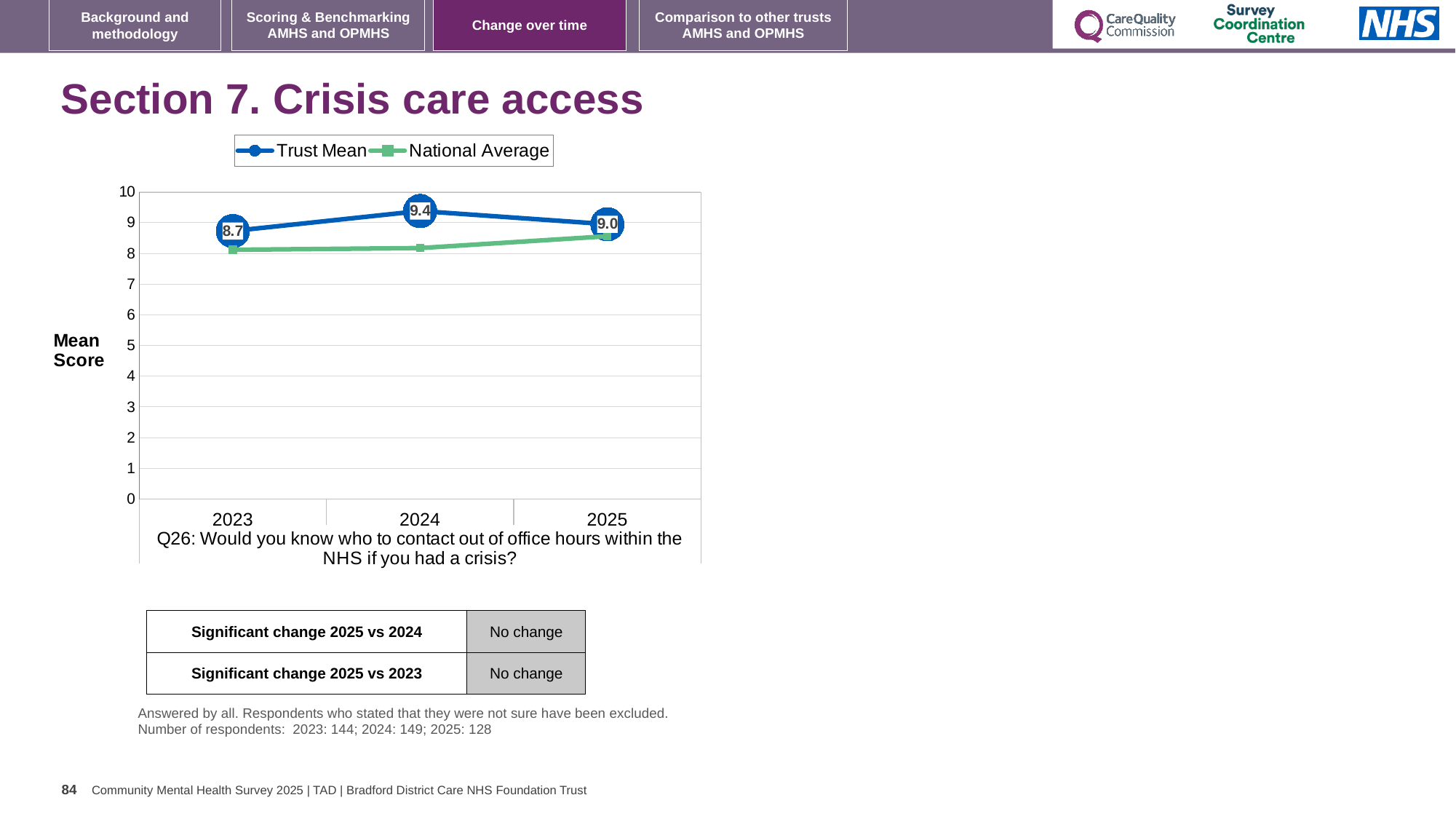
Is the National Average value for 2023 greater or less than 9? less Which is larger, the Trust Mean score for 2024 or for 2025? 2024 What is the difference between the Trust Mean scores for 2024 and 2023? 0.7 How many series does the legend list? 2 What kind of chart is shown on the slide? Line chart What is the Trust Mean score for 2025? 9.0 In which year is the Trust Mean score highest? 2024 What is the Trust Mean score for 2023? 8.7 In which year is the Trust Mean score lowest? 2023 How many years are plotted on the x axis? 3 In 2024, which series has the higher value, Trust Mean or National Average? Trust Mean What is the Trust Mean score for 2024? 9.4